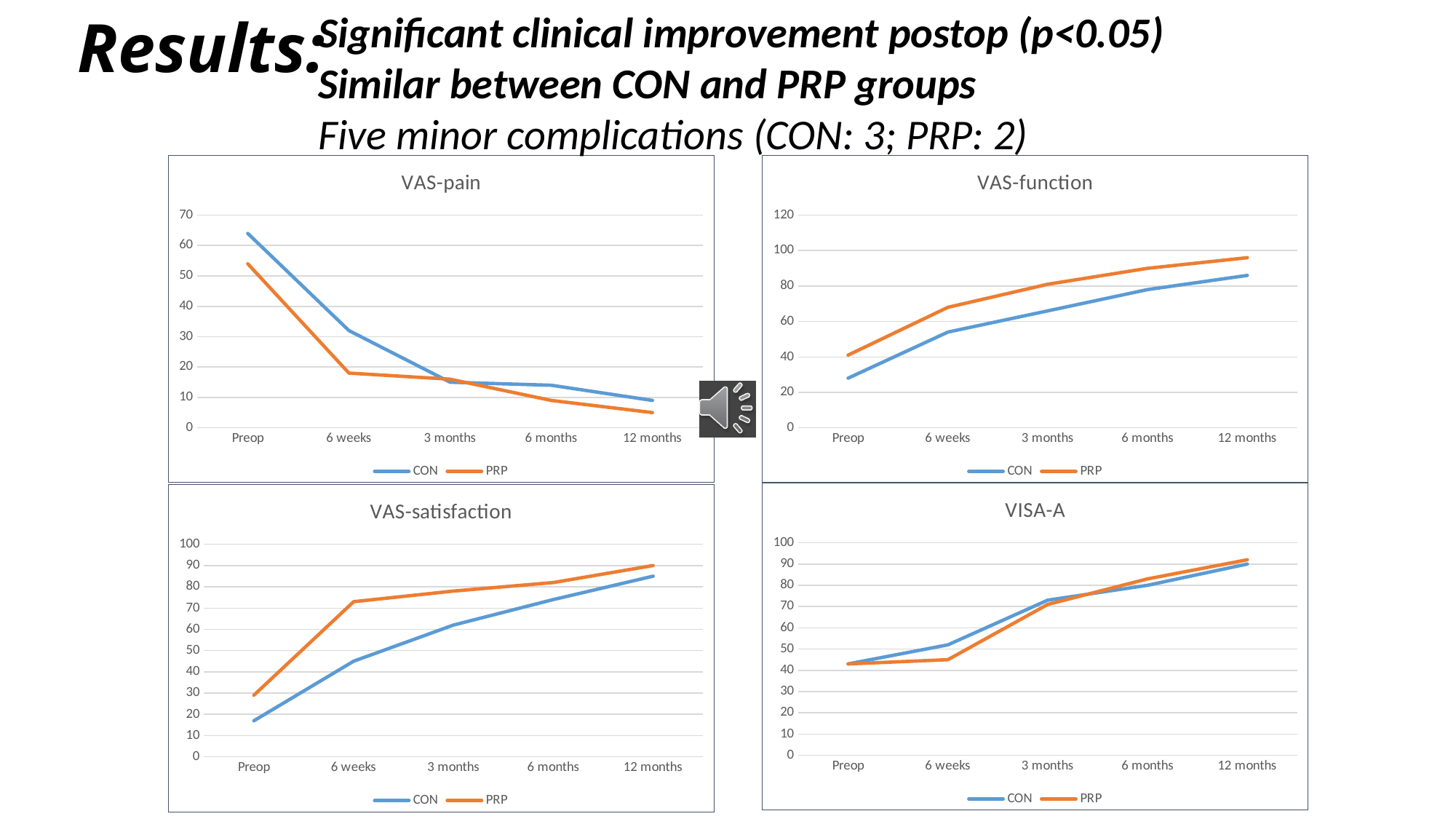
How many series does the legend of the VAS-function chart list? 2 How many time points are shown on the x axis of the VAS-satisfaction chart? 5 In the VAS-pain chart, at which time point is the PRP value lowest? 12 months In the VAS-function chart, does the PRP line rise or fall from Preop to 12 months? rise In the VAS-pain chart, is the CON value at Preop greater or less than 60? greater In the VAS-pain chart, which group has the higher value at Preop, CON or PRP? CON In the VAS-function chart, at which time point is the CON value highest? 12 months In the VAS-satisfaction chart, is the CON value at Preop greater or less than 20? less In the VAS-function chart, is the PRP value at 12 months greater or less than 90? greater What kind of chart is the VAS-pain chart? line chart In the VAS-pain chart, does the CON line rise or fall from Preop to 12 months? fall In the VAS-satisfaction chart, which group has the higher value at 6 weeks, CON or PRP? PRP